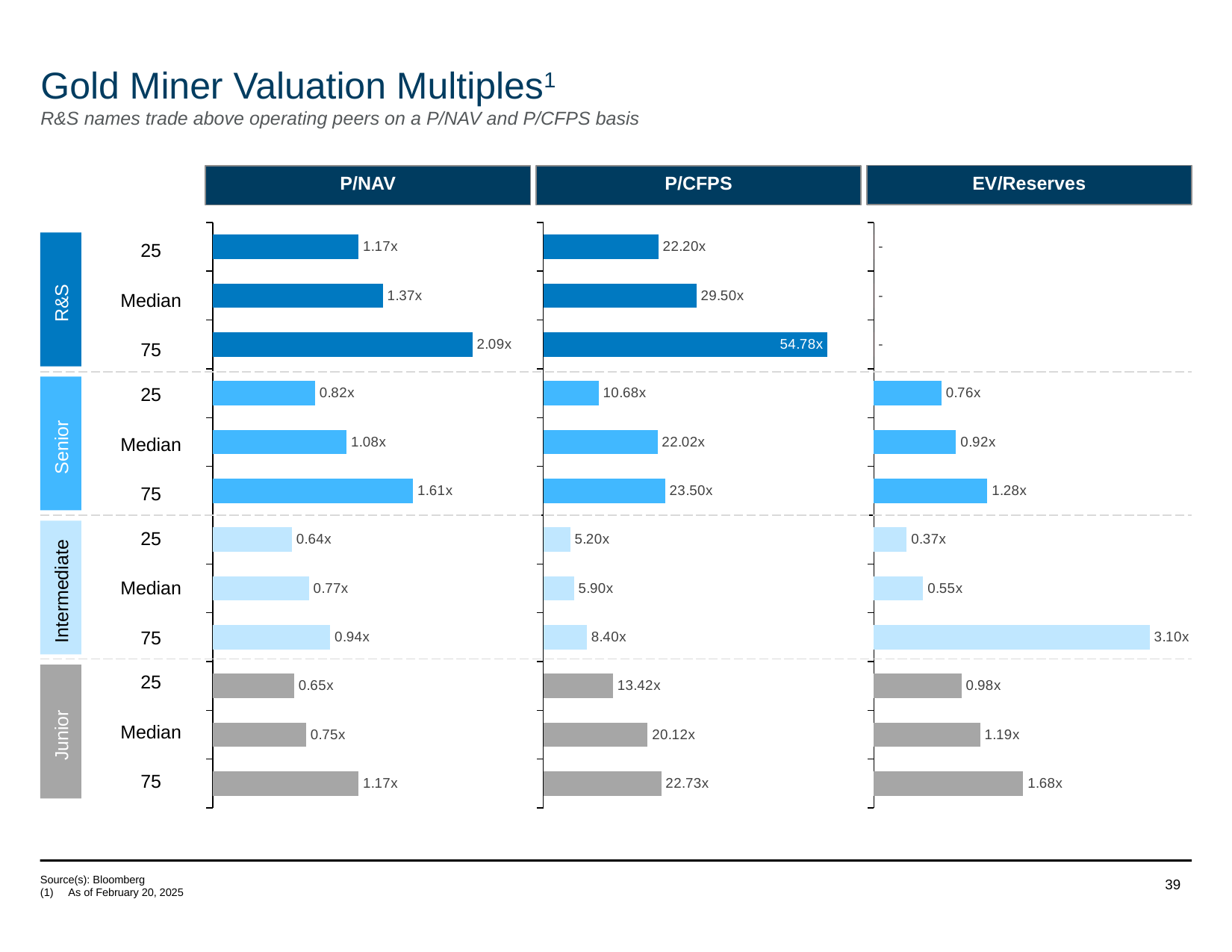
In the EV/Reserves chart, which is larger: the Senior Median or the Junior Median? Junior Median In the P/NAV chart, what is the difference between the R&S Median and the Senior Median? 0.29x In the EV/Reserves chart, what is the 25th percentile value for Junior miners? 0.98x How many bars are plotted in the EV/Reserves chart? 9 What type of chart is used to show the valuation multiples on this slide? Bar chart In the P/NAV chart, which is larger: the Intermediate 75th percentile or the Junior 75th percentile? Junior 75th percentile In the EV/Reserves chart, which group and percentile has the highest value? Intermediate 75 In the P/NAV chart, what is the Median value for Senior miners? 1.08x In the P/CFPS chart, which group and percentile has the lowest value? Intermediate 25 In the P/CFPS chart, what is the 75th percentile value for R&S miners? 54.78x In the P/NAV chart, which group and percentile has the highest value? R&S 75 In the P/CFPS chart, what is the difference between the Junior 75th percentile and the Junior 25th percentile? 9.31x